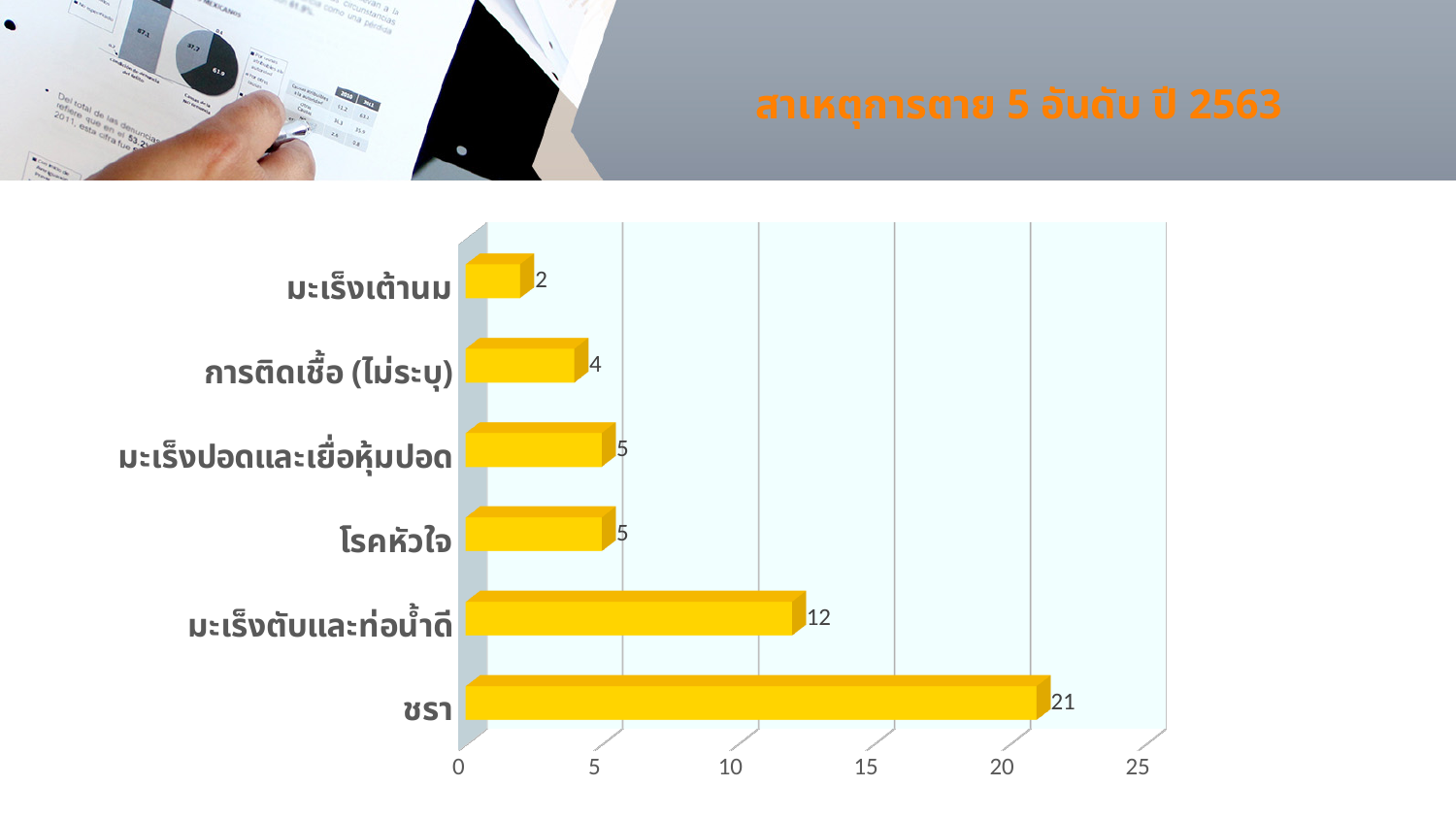
What is the value for มะเร็งเต้านม? 2 What is the value for ชรา? 21 What kind of chart is shown on the slide? bar chart How many categories are shown in the chart? 6 What is the title of the slide? สาเหตุการตาย 5 อันดับ ปี 2563 What is the difference between the values for ชรา and มะเร็งตับและท่อน้ำดี? 9 Which category has the lowest value? มะเร็งเต้านม What is the value for การติดเชื้อ (ไม่ระบุ)? 4 Which category has the highest value? ชรา Which is larger, the value for โรคหัวใจ or the value for การติดเชื้อ (ไม่ระบุ)? โรคหัวใจ Is the value for ชรา greater or less than 20? greater What is the value for มะเร็งตับและท่อน้ำดี? 12